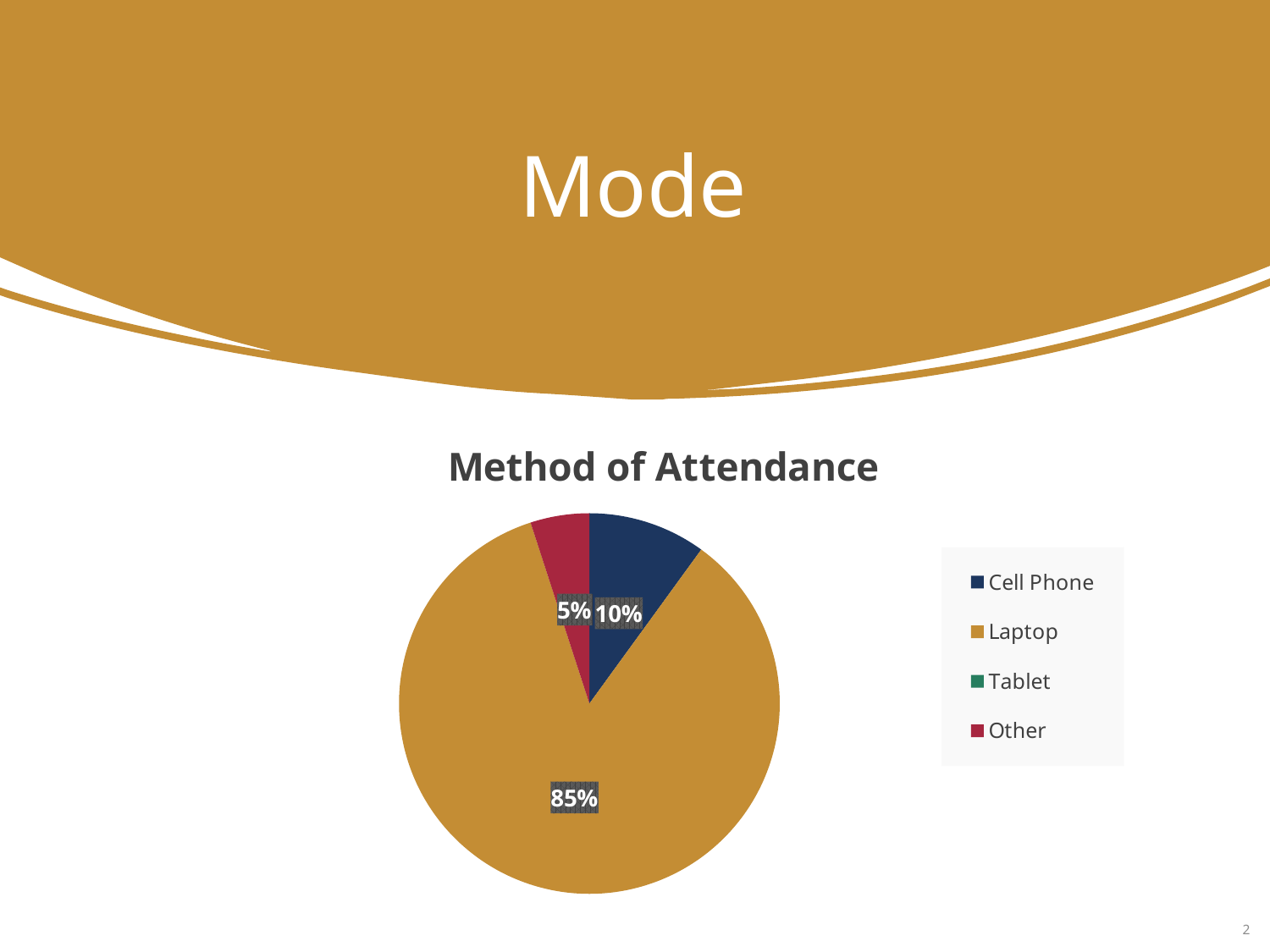
How many entries does the legend list? 4 What share of the pie does Laptop represent? 85% What is the title of the chart? Method of Attendance Which legend entry is shown in red? Other What share of the pie does Cell Phone represent? 10% What type of chart is shown on the slide? pie chart Which is larger, the share for Cell Phone or the share for Other? Cell Phone What is the difference between the Laptop share and the Cell Phone share? 75% What share of the pie does Other represent? 5% Which method of attendance has the largest share? Laptop Is the share for Laptop greater or less than 50%? greater What is the difference between the Cell Phone share and the Other share? 5%